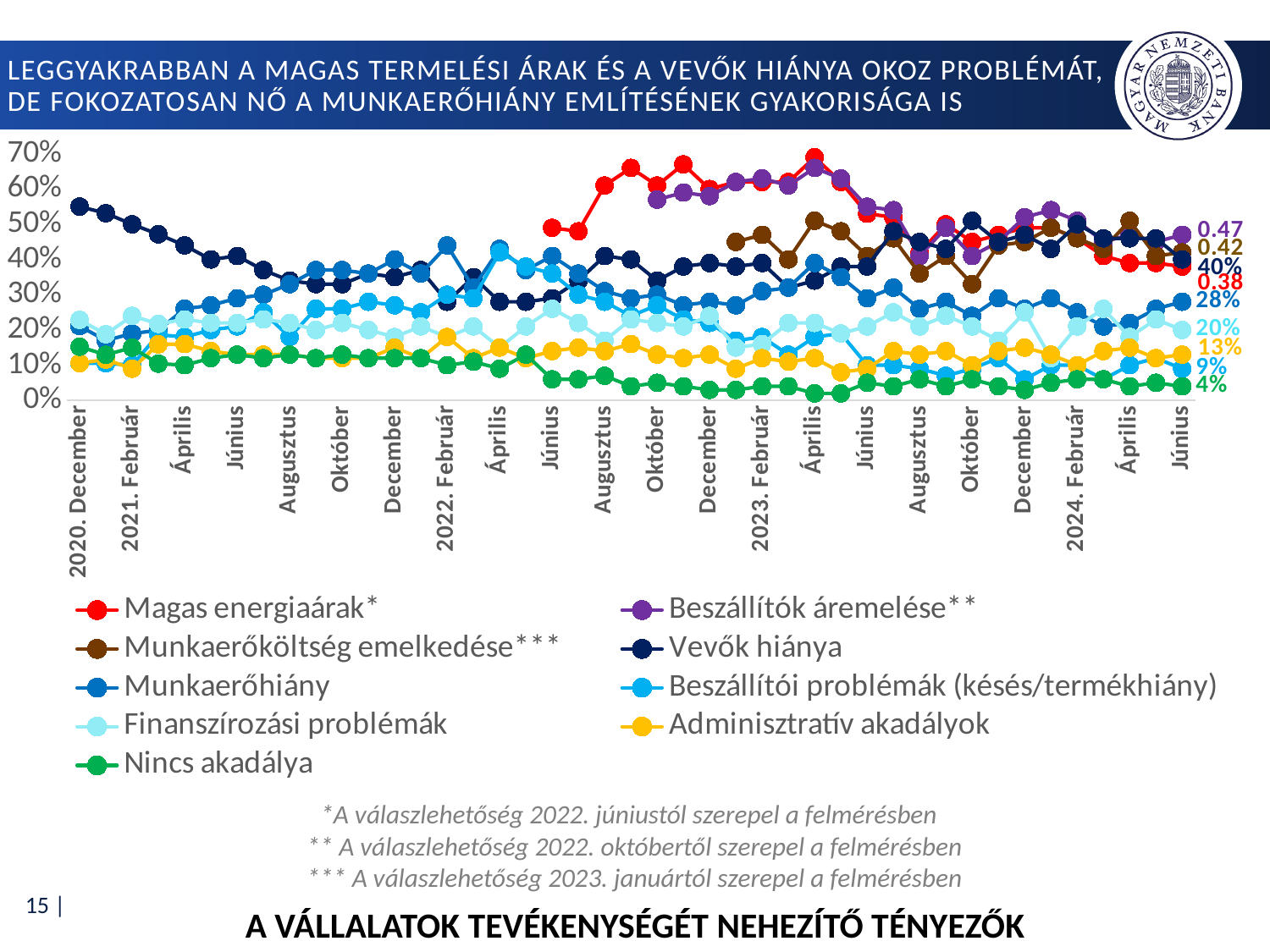
What is the value shown for Nincs akadálya at the last data point (2024 Június)? 4% How many series does the legend list? 9 What kind of chart is shown on the slide? Line chart What is the difference between the final values of Vevők hiánya (40%) and Munkaerőhiány (28%)? 12 percentage points Is the value for Magas energiaárak in 2023 Április greater or less than 60%? greater Is the value for Vevők hiánya in 2020 December greater or less than 50%? greater What is the value shown for Munkaerőhiány at the last data point (2024 Június)? 28% Which series has the highest value at the last data point (2024 Június)? Beszállítók áremelése Which series has the lowest value at the last data point (2024 Június)? Nincs akadálya What is the value shown for Beszállítók áremelése at the end of the series (2024 Június)? 0.47 At the last data point, which is larger: Adminisztratív akadályok or Beszállítói problémák (késés/termékhiány)? Adminisztratív akadályok What is the value shown for Vevők hiánya at the last data point (2024 Június)? 40%